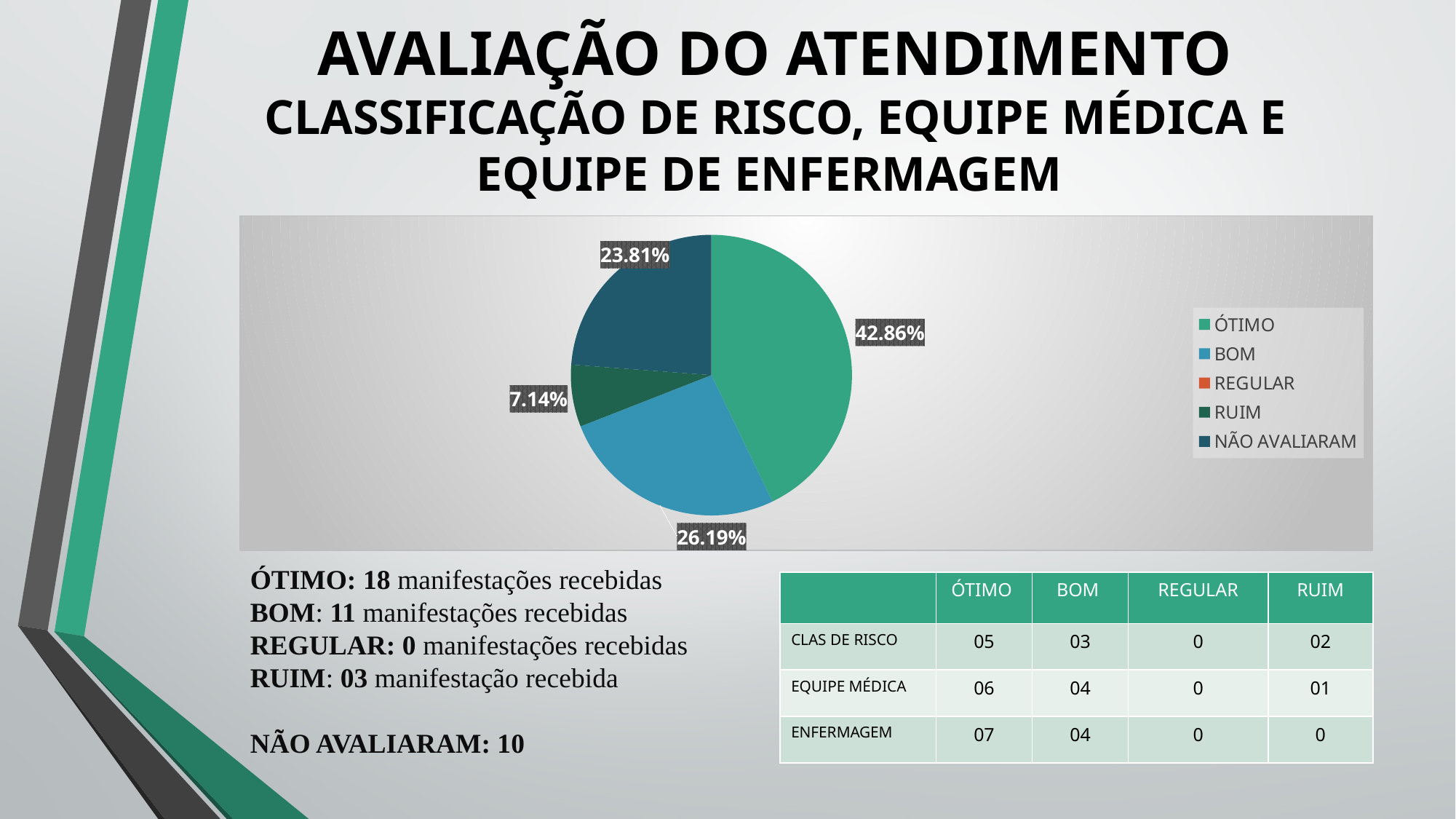
Which of the labelled slices of the pie chart is the smallest? RUIM What kind of chart is shown on the slide? pie chart How many entries does the legend of the pie chart list? 5 What percentage does the NÃO AVALIARAM slice of the pie chart show? 23.81% What is the difference in percentage points between the NÃO AVALIARAM slice and the RUIM slice? 16.67 Which category has the largest slice of the pie chart? ÓTIMO What percentage does the RUIM slice of the pie chart show? 7.14% What percentage does the BOM slice of the pie chart show? 26.19% What percentage does the ÓTIMO slice of the pie chart show? 42.86% Which slice is larger in the pie chart, BOM or NÃO AVALIARAM? BOM What is the difference in percentage points between the ÓTIMO slice and the BOM slice? 16.67 How many slices of the pie chart have a percentage label? 4